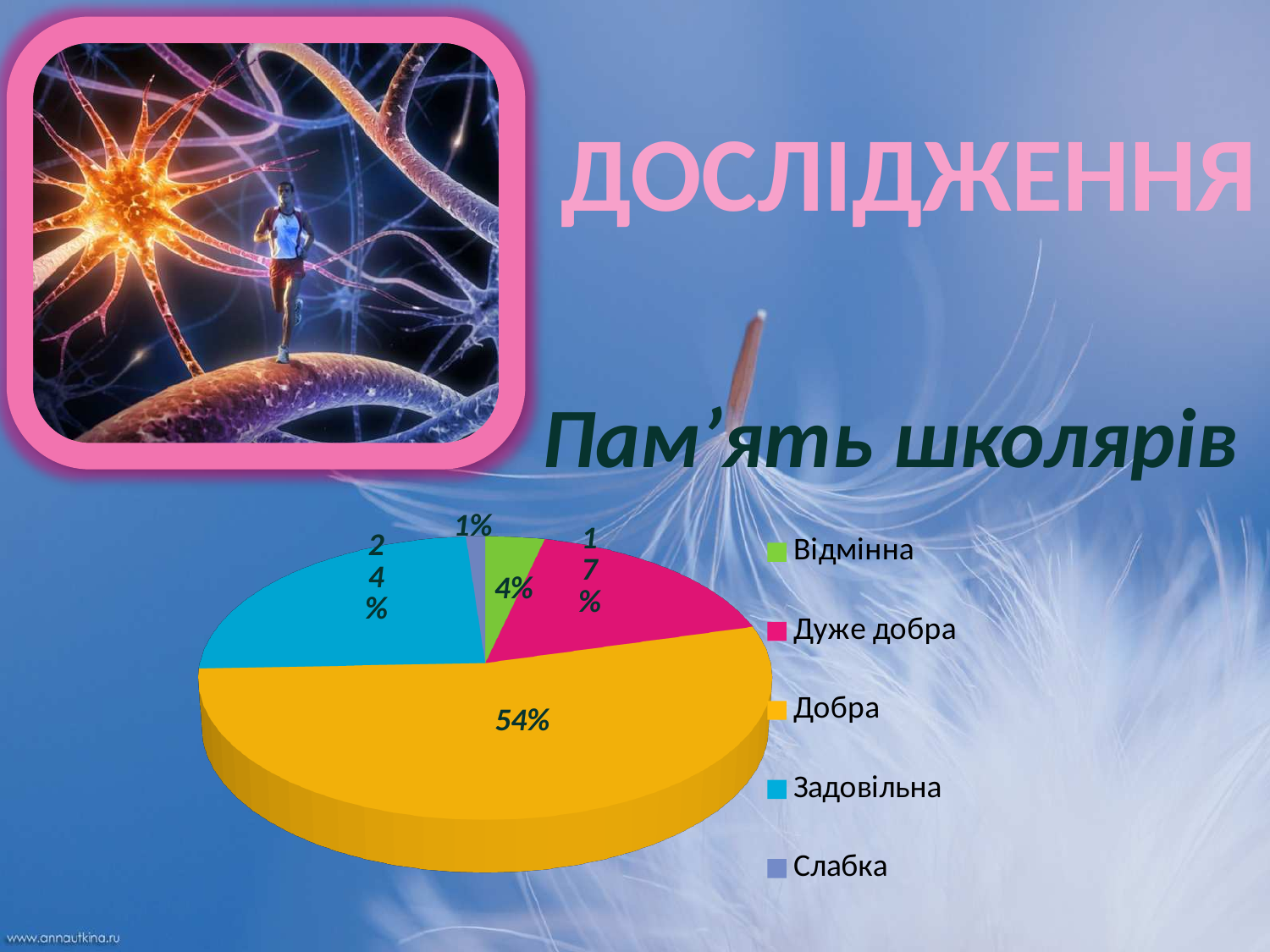
What share of the pie does the "Відмінна" slice represent? 4% How many categories does the legend of the pie chart list? 5 What share of the pie does the "Слабка" slice represent? 1% What share of the pie does the "Добра" slice represent? 54% What share of the pie does the "Дуже добра" slice represent? 17% Which category has the largest slice of the pie? Добра What colour is the "Добра" slice of the pie chart? yellow What kind of chart is shown on the slide? pie chart What is the difference between the shares of "Добра" and "Задовільна"? 30% Which category has the smallest slice of the pie? Слабка Which is larger, the share for "Дуже добра" or the share for "Задовільна"? Задовільна What share of the pie does the "Задовільна" slice represent? 24%